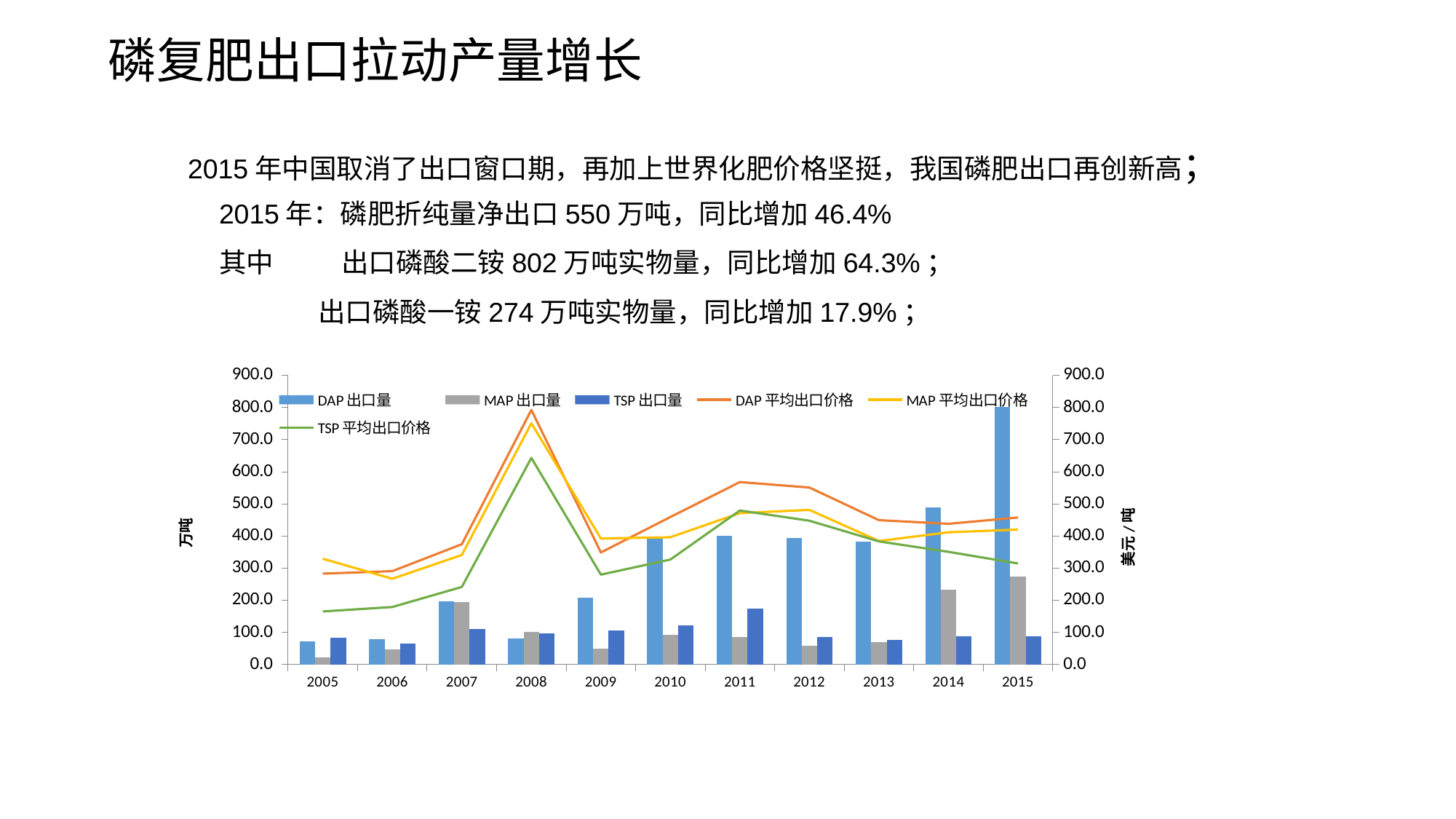
In which year is MAP出口量 lowest? 2005 In which year is DAP平均出口价格 highest? 2008 What is the label on the right-hand vertical axis of the chart? 美元/吨 How many years are shown on the x axis of the chart? 11 Is the value for DAP出口量 in 2015 greater or less than 700? greater Is the value for TSP平均出口价格 in 2015 greater or less than 400? less Which year has the larger DAP出口量, 2013 or 2014? 2014 Does TSP平均出口价格 rise or fall from 2011 to 2015? fall How many series does the chart's legend list? 6 What kind of chart is shown on the slide? A combined bar and line chart In which year is DAP出口量 highest? 2015 In which year is TSP出口量 highest? 2011